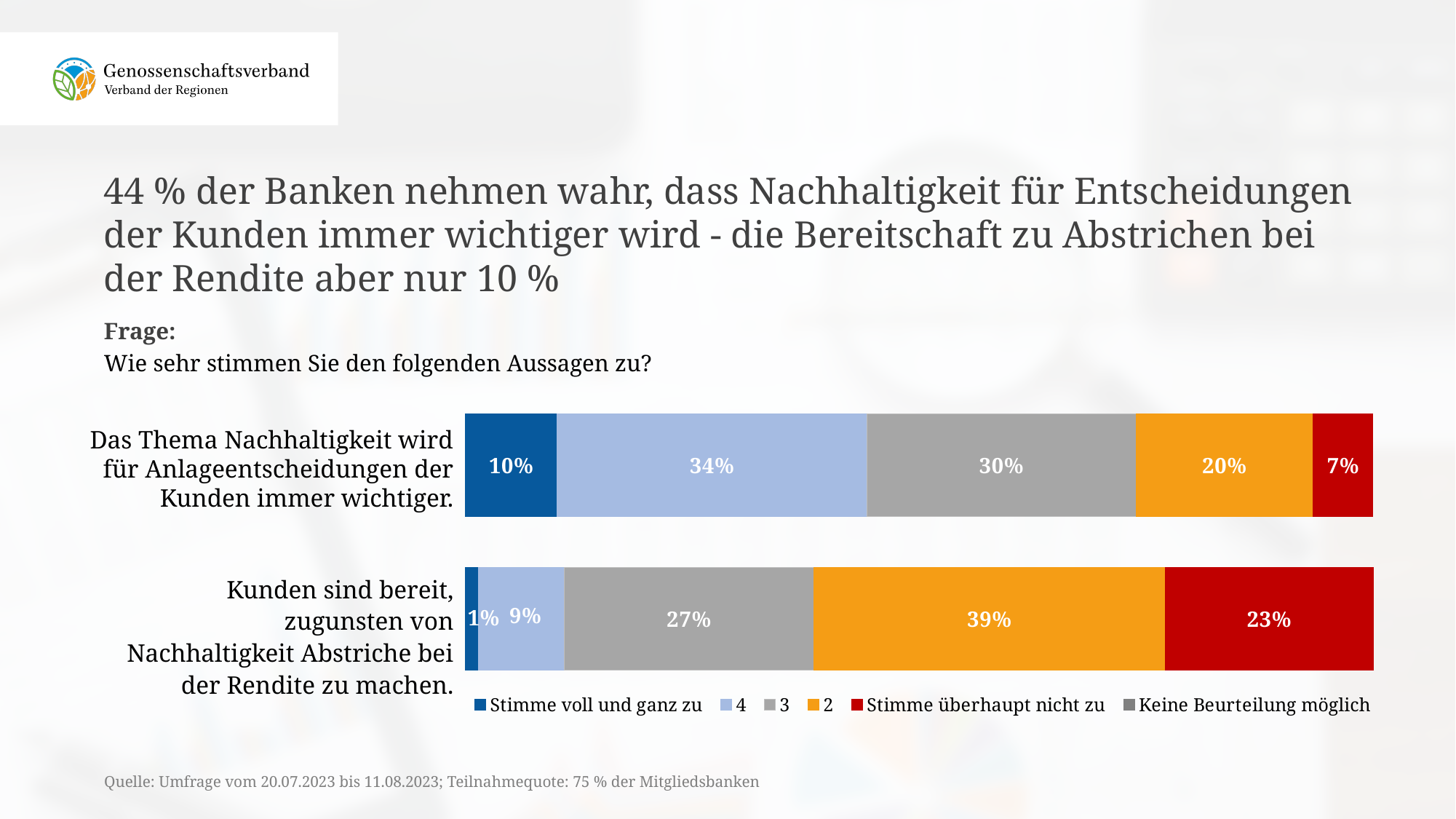
How many statements are shown in the chart? 2 How many entries does the legend list? 6 What kind of chart is shown on the slide? Stacked bar chart Which response category has the largest share for the statement "Kunden sind bereit, zugunsten von Nachhaltigkeit Abstriche bei der Rendite zu machen"? 2 What is the value for rating "2" for the statement "Kunden sind bereit, zugunsten von Nachhaltigkeit Abstriche bei der Rendite zu machen"? 39% Which response category has the smallest share for the statement "Das Thema Nachhaltigkeit wird für Anlageentscheidungen der Kunden immer wichtiger"? Stimme überhaupt nicht zu Which statement has the larger share for rating "3"? Das Thema Nachhaltigkeit wird für Anlageentscheidungen der Kunden immer wichtiger. What is the value for rating "4" for the statement "Das Thema Nachhaltigkeit wird für Anlageentscheidungen der Kunden immer wichtiger"? 34% What is the difference between the "Stimme überhaupt nicht zu" shares of the two statements? 16% What colour represents "Stimme überhaupt nicht zu" in the chart? Red What percentage of banks answered "Stimme voll und ganz zu" to the statement "Das Thema Nachhaltigkeit wird für Anlageentscheidungen der Kunden immer wichtiger"? 10% What percentage of banks answered "Stimme überhaupt nicht zu" to the statement "Kunden sind bereit, zugunsten von Nachhaltigkeit Abstriche bei der Rendite zu machen"? 23%